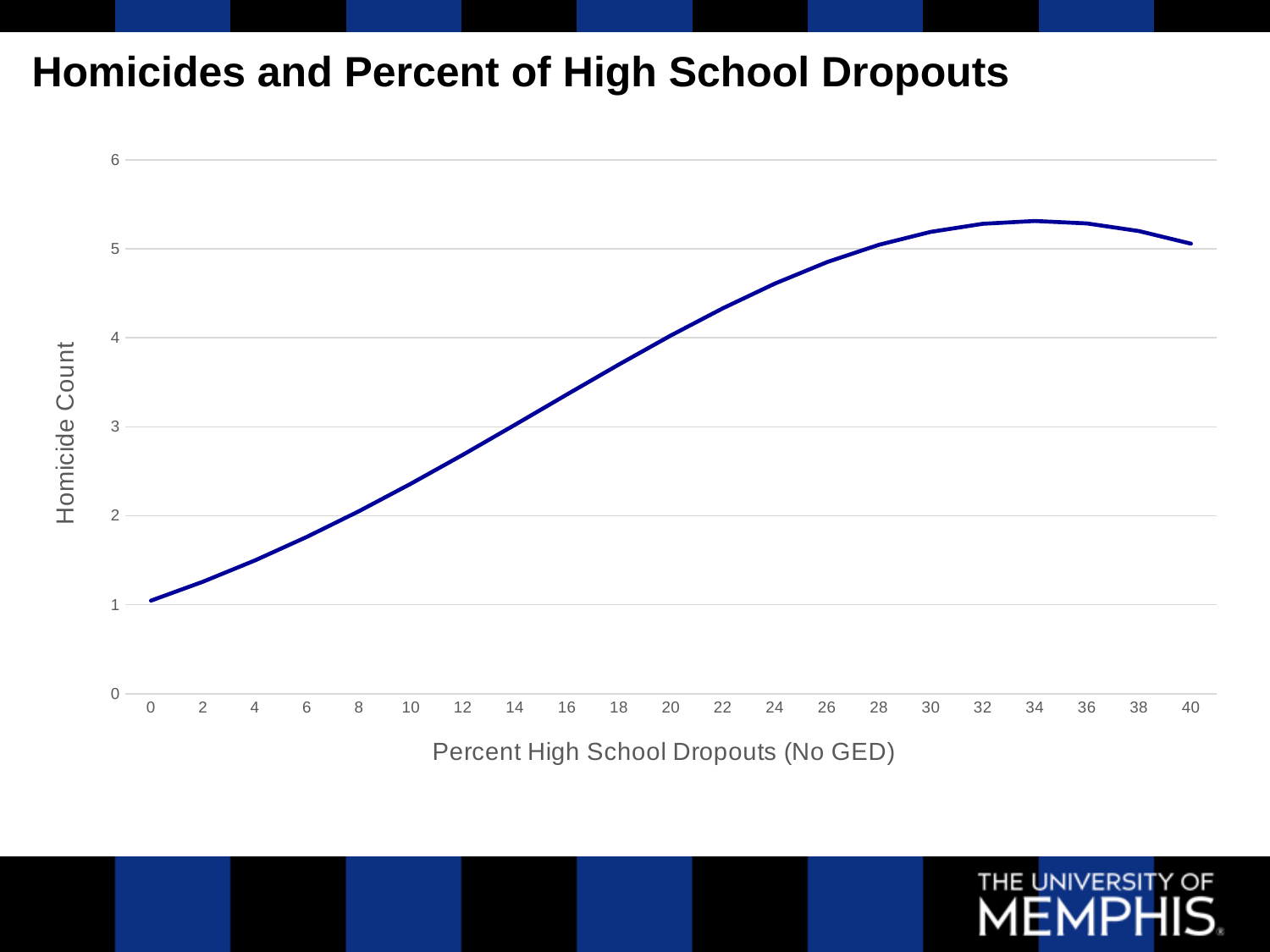
Is the homicide count at 4 percent dropouts greater or less than 2? less What kind of chart is shown on the slide? line chart Is the homicide count at 6 percent dropouts greater or less than 2? less What is the label of the y axis? Homicide Count Does the homicide count rise or fall as the percent of dropouts increases from 0 to 30? rise What is the title of the chart? Homicides and Percent of High School Dropouts Is the homicide count at 16 percent dropouts greater or less than 3? greater How many tick labels are shown on the x axis? 21 Which is larger, the homicide count at 12 percent dropouts or at 28 percent dropouts? 28 percent dropouts